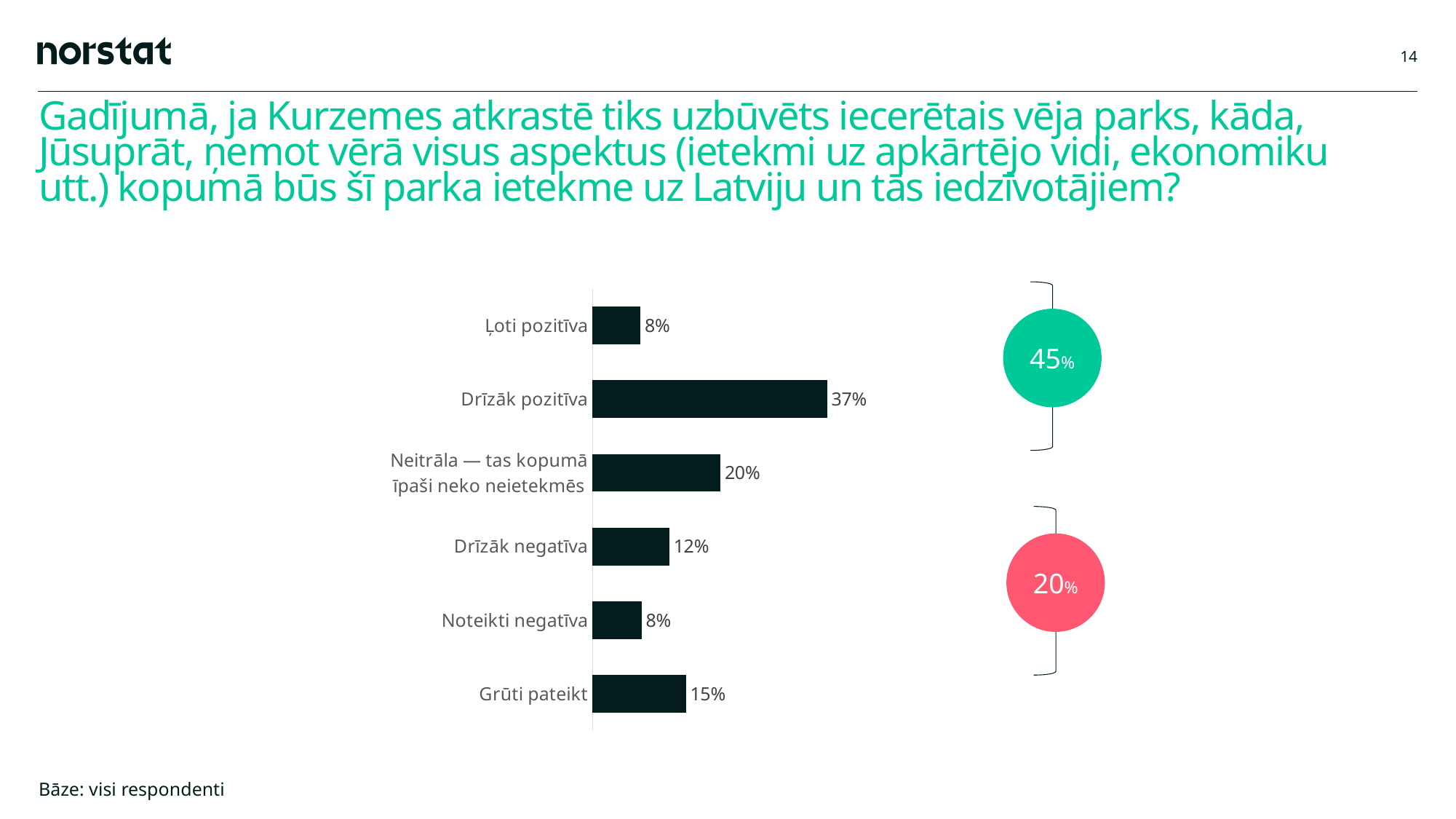
What combined percentage is shown in the red circle next to the negative categories? 20% What is the value for "Neitrāla — tas kopumā īpaši neko neietekmēs"? 20% What is the value for "Drīzāk pozitīva"? 37% What is the value for "Drīzāk negatīva"? 12% What kind of chart is shown on the slide? Bar chart What is the difference between "Drīzāk pozitīva" and "Drīzāk negatīva"? 25% What combined percentage is shown in the green circle next to the positive categories? 45% What is the difference between "Neitrāla — tas kopumā īpaši neko neietekmēs" and "Grūti pateikt"? 5% What is the value for "Grūti pateikt"? 15% Which category has the highest value? Drīzāk pozitīva How many categories are shown in the bar chart? 6 Which is larger, "Drīzāk negatīva" or "Noteikti negatīva"? Drīzāk negatīva